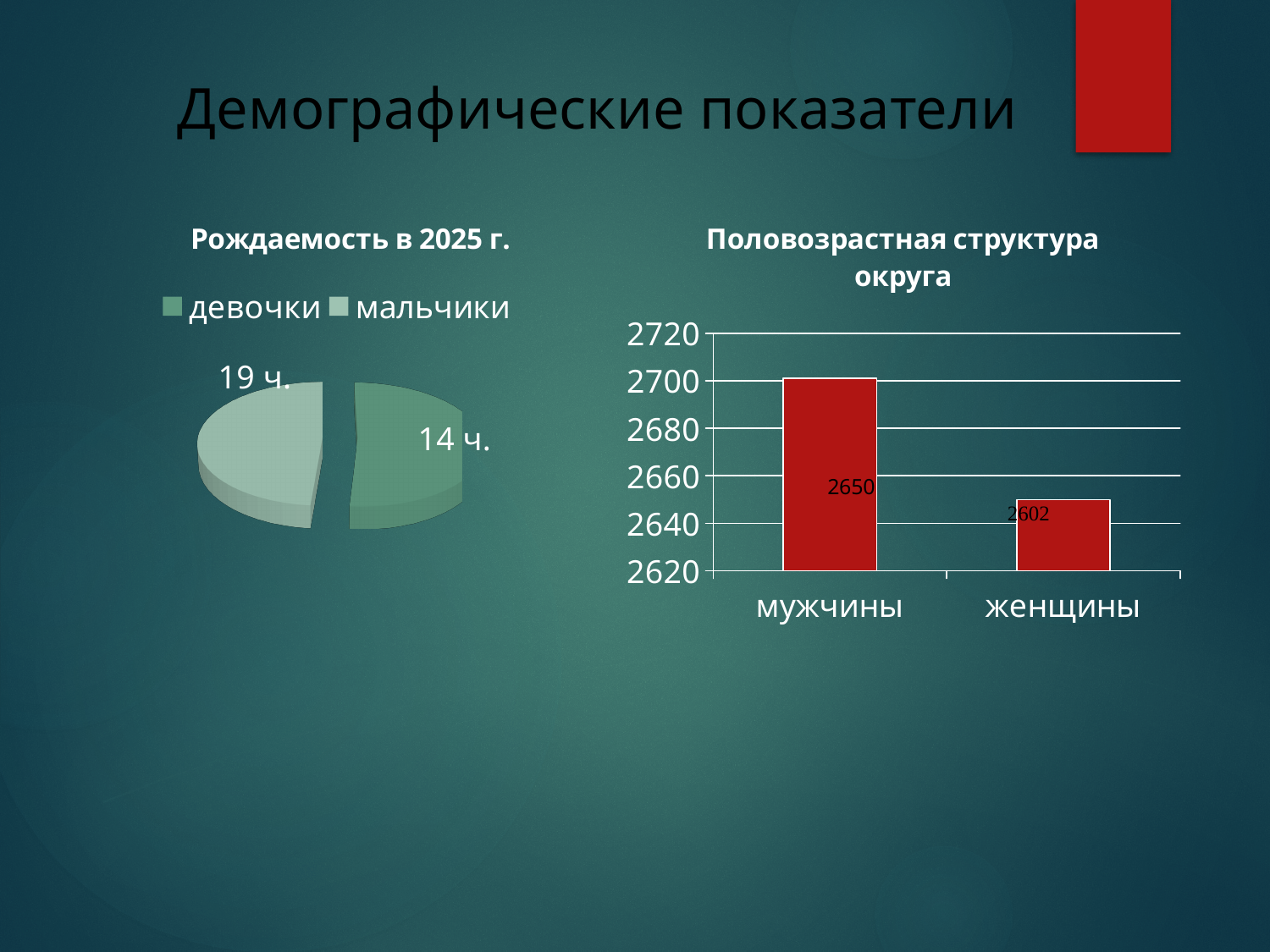
What kind of chart is 'Половозрастная структура округа'? bar chart What kind of chart is 'Рождаемость в 2025 г.'? pie chart In the chart 'Половозрастная структура округа', which category has the lowest value? женщины In the pie chart 'Рождаемость в 2025 г.', how many slices are there? 2 What is the title of the chart on the right side of the slide? Половозрастная структура округа In the pie chart 'Рождаемость в 2025 г.', what is the value for девочки? 14 ч. In the pie chart 'Рождаемость в 2025 г.', how many entries does the legend list? 2 In the pie chart 'Рождаемость в 2025 г.', what is the value for мальчики? 19 ч.